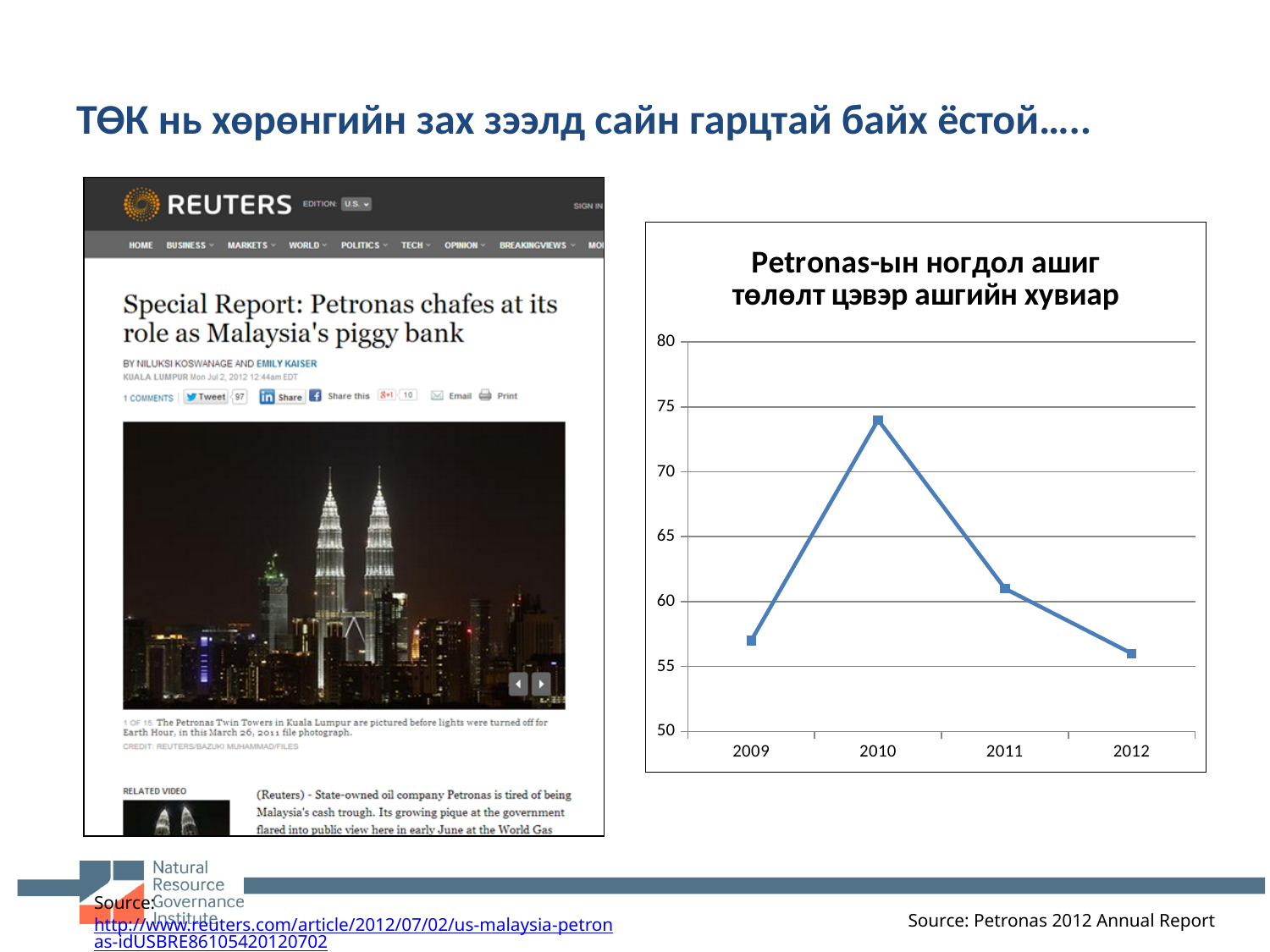
Which year has the highest value in the chart? 2010 Is the value for 2012 greater or less than 60? less What kind of chart is shown on the slide? line chart Is the value for 2010 greater or less than 70? greater Which is larger, the value for 2010 or the value for 2011? 2010 What is the first year shown on the x axis of the chart? 2009 How many years are plotted on the x axis of the chart? 4 Is the value for 2009 greater or less than 60? less Do the values rise or fall from 2010 to 2012? fall Which is larger, the value for 2009 or the value for 2011? 2011 What is the title of the chart? Petronas-ын ногдол ашиг төлөлт цэвэр ашгийн хувиар